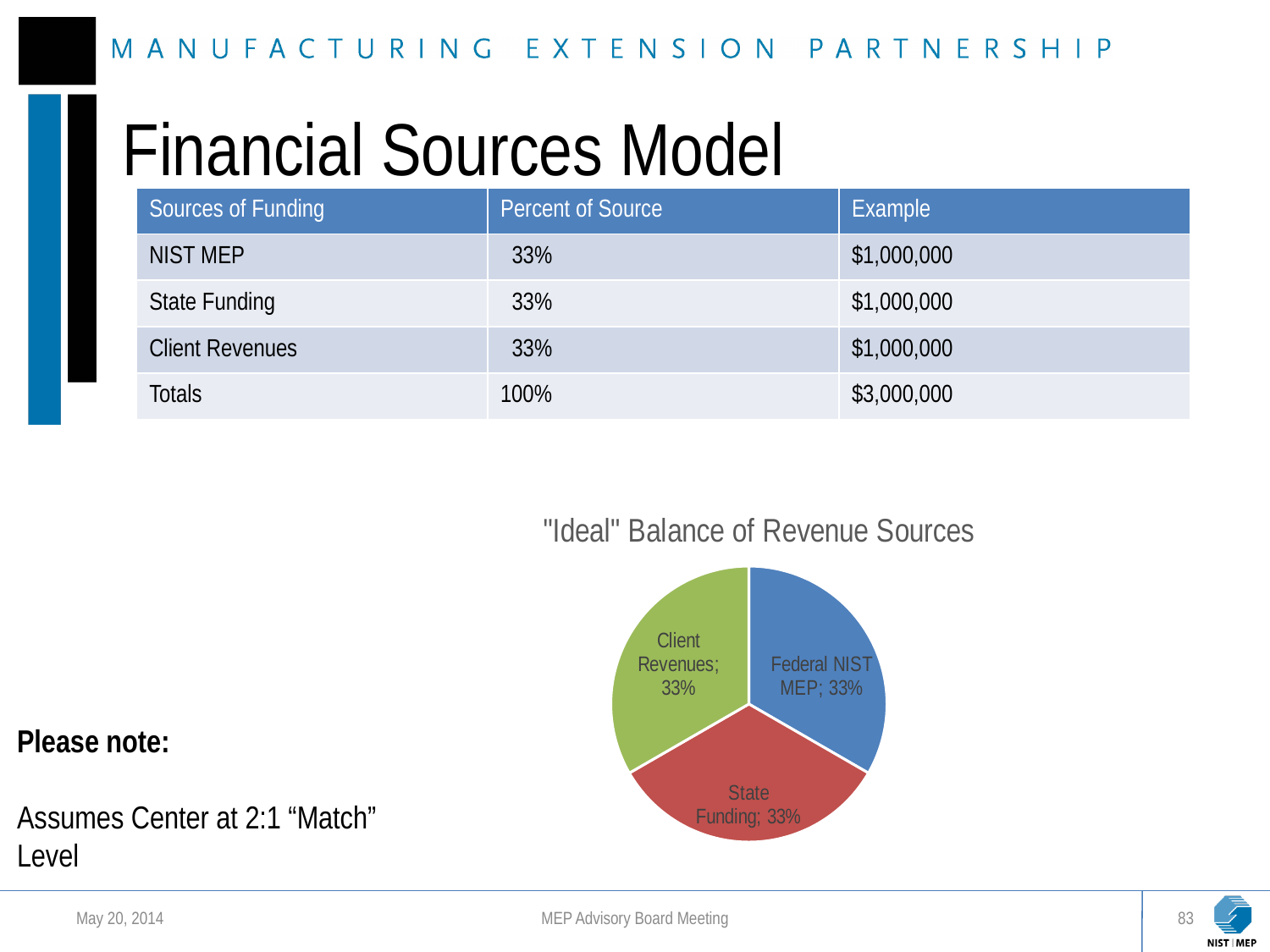
What share of the pie does Client Revenues represent? 33% What percentage is shown for the Federal NIST MEP slice in the pie chart? 33% What percentage is shown for the Client Revenues slice in the pie chart? 33% What is the title of the pie chart? "Ideal" Balance of Revenue Sources What is the difference between the Federal NIST MEP and Client Revenues slices in the pie chart? 0% Is the value for State Funding in the pie chart greater or less than 25%? greater Is the value for Federal NIST MEP in the pie chart greater or less than 50%? less What percentage is shown for the State Funding slice in the pie chart? 33% How many slices does the pie chart have? 3 What type of chart is shown on the slide? Pie chart What colour is the State Funding slice in the pie chart? Red